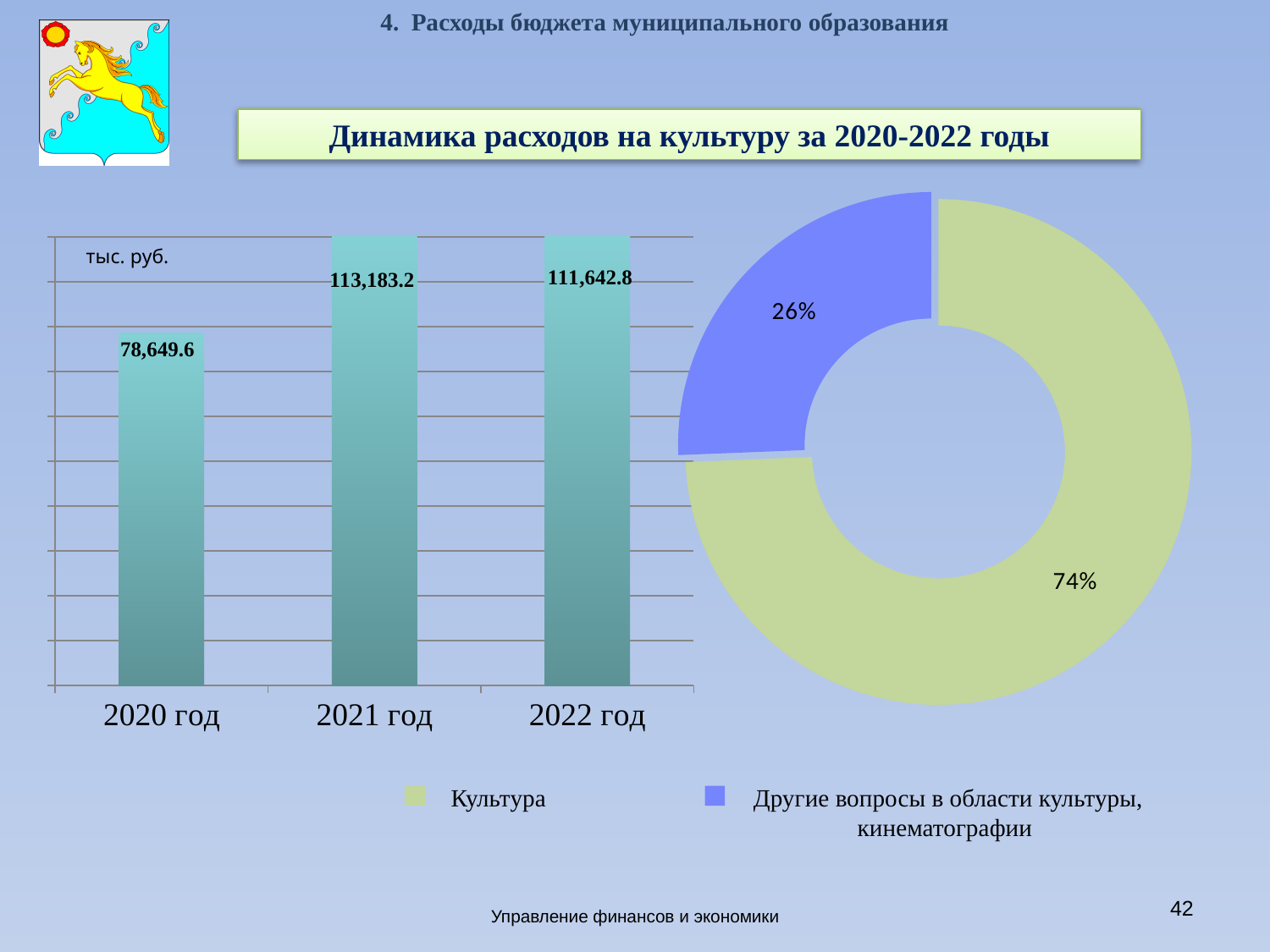
In the bar chart on the left, how many years are shown? 3 In the bar chart on the left, which is larger: the value for 2021 год or 2022 год? 2021 год In the bar chart on the left, what is the value for 2020 год? 78,649.6 In the bar chart on the left, what unit is indicated for the values? тыс. руб. In the bar chart on the left, what is the value for 2022 год? 111,642.8 In the bar chart on the left, what is the difference between the values for 2021 год and 2020 год? 34,533.6 In the bar chart on the left, which year has the lowest value? 2020 год What type of chart is shown on the left side of the slide? Bar chart In the bar chart on the left, which year has the highest value? 2021 год In the bar chart on the left, what is the value for 2021 год? 113,183.2 In the doughnut chart on the right, what share does Другие вопросы в области культуры, кинематографии have? 26% In the doughnut chart on the right, what share does Культура have? 74%